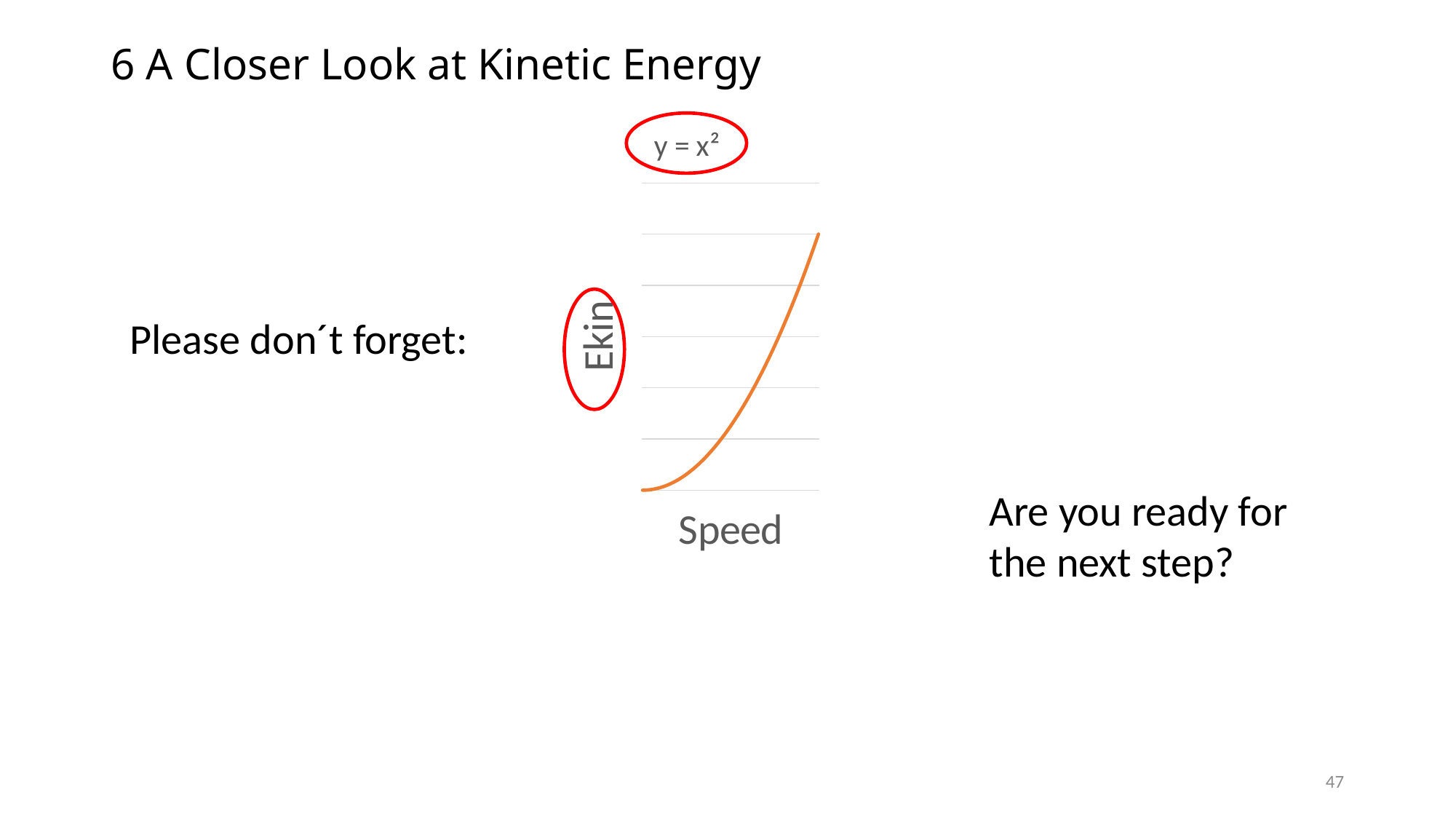
What kind of chart is shown on the slide? line chart What is the label on the vertical axis of the chart? Ekin What is the title of the chart? y = x² How many lines are plotted on the chart? 1 Do the values on the chart rise or fall as speed increases along the x axis? rise